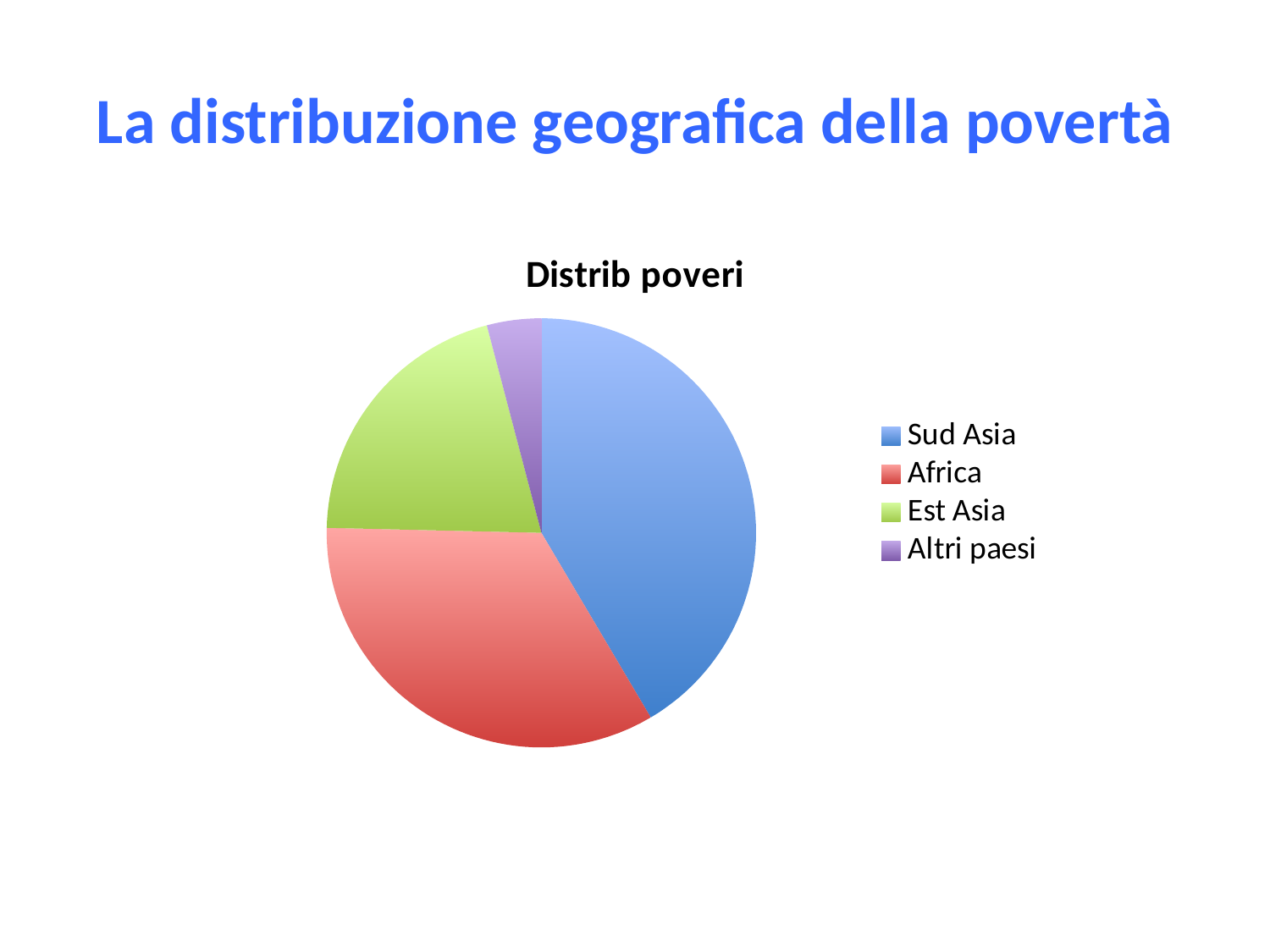
Which slice is larger, Sud Asia or Africa? Sud Asia Which category has the largest slice of the pie? Sud Asia Which slice is larger, Africa or Est Asia? Africa What is the title of the chart? Distrib poveri Which category is shown in green in the pie chart? Est Asia What kind of chart is shown on the slide? pie chart Which category has the smallest slice of the pie? Altri paesi How many slices does the pie chart have? 4 Which slice is larger, Est Asia or Altri paesi? Est Asia Which category has the second-largest slice of the pie? Africa